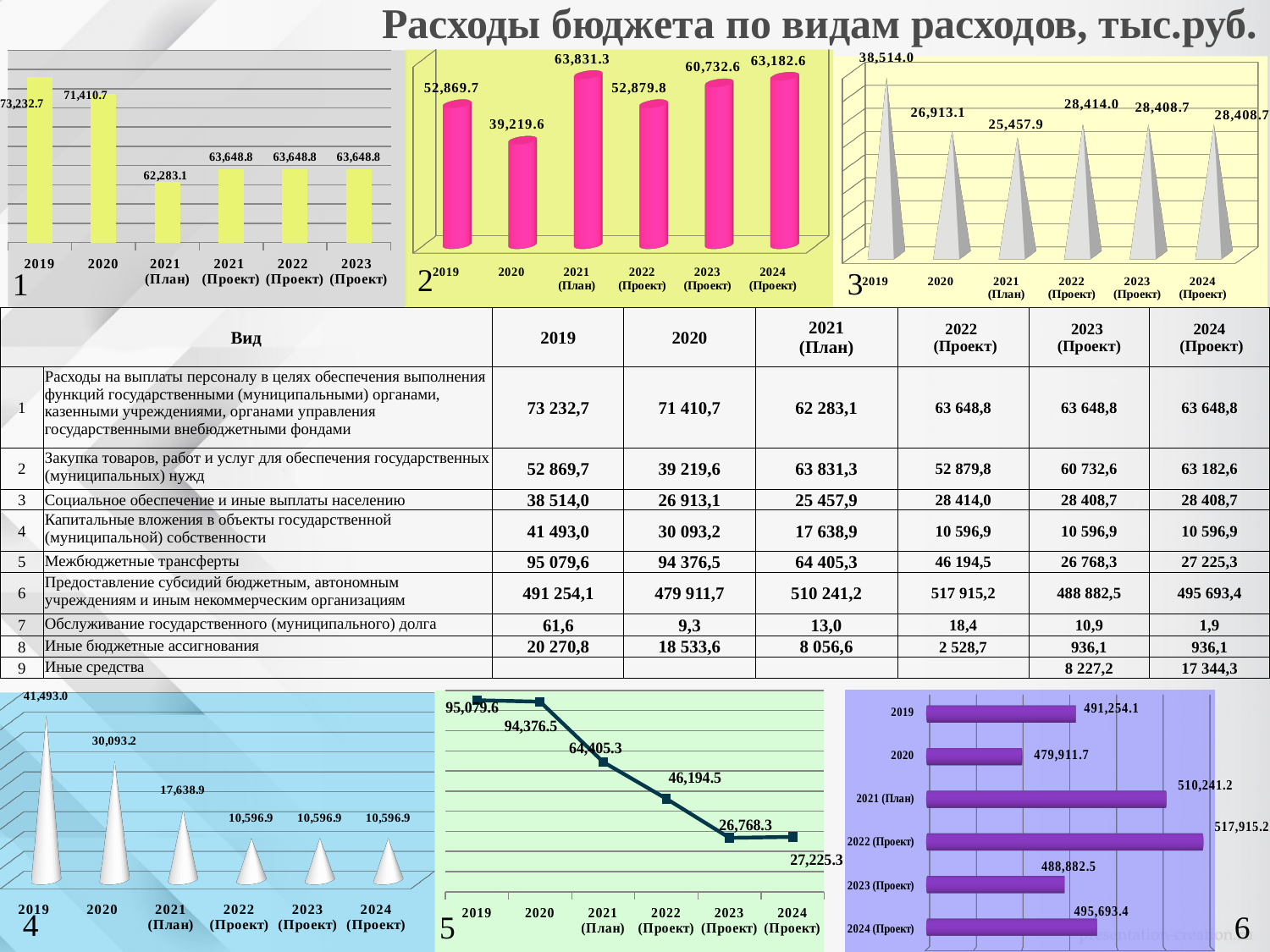
In chart 6 (bottom-right, purple horizontal bars), how many categories are plotted? 6 In chart 6 (bottom-right, purple horizontal bars), which category has the highest value? 2022 (Проект) What kind of chart is chart 5 (bottom-middle)? line chart In chart 4 (bottom-left, white cones), do the values rise or fall from 2019 to 2024 (Проект)? fall In chart 5 (bottom-middle, line chart), what is the difference between the 2019 value and the 2024 (Проект) value? 67,854.3 In chart 4 (bottom-left, white cones), what is the value for 2021 (План)? 17,638.9 In chart 2 (top-middle, pink bars), what is the value for 2020? 39,219.6 In chart 2 (top-middle, pink bars), what is the difference between the 2021 (План) value and the 2020 value? 24,611.7 In chart 1 (top-left, yellow bars), what is the value for 2019? 73,232.7 In chart 3 (top-right, grey cones), what is the value for 2019? 38,514.0 In chart 2 (top-middle, pink bars), which category has the highest value? 2021 (План) In chart 1 (top-left, yellow bars), which year has the lowest value? 2021 (План)